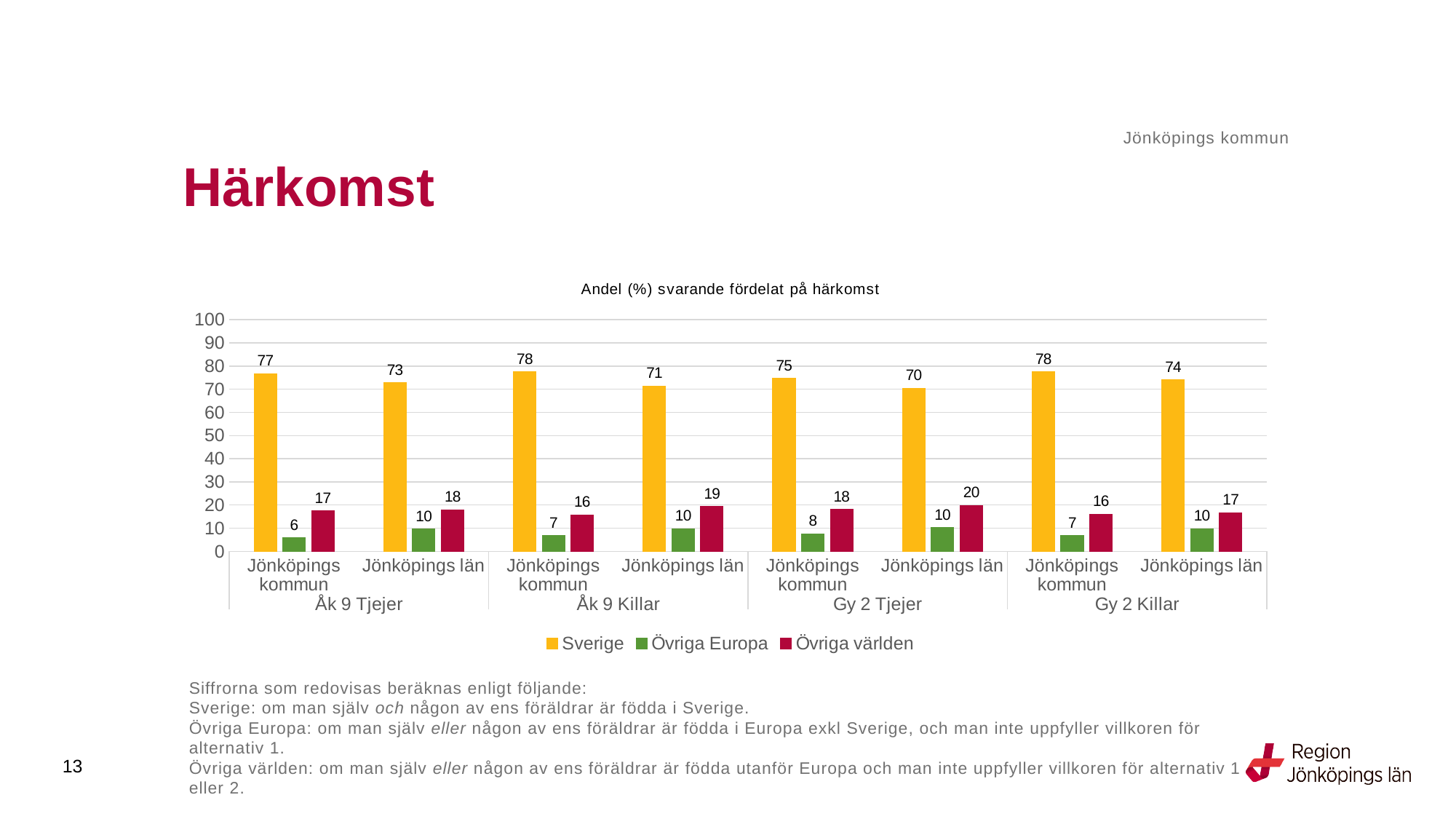
What kind of chart is shown on the slide? bar chart What is the difference between the Sverige values for Jönköpings kommun and Jönköpings län in the Gy 2 Tjejer group? 5 Which colour represents Övriga Europa in the chart? green Which is larger: Övriga världen for Jönköpings län in Åk 9 Killar or Övriga världen for Jönköpings kommun in Åk 9 Killar? Jönköpings län in Åk 9 Killar (19) Which group and area has the highest Sverige value? Jönköpings kommun in Åk 9 Killar and Gy 2 Killar (78) What is the value for Sverige for Jönköpings kommun in the Åk 9 Tjejer group? 77 Which group and area has the lowest Övriga Europa value? Jönköpings kommun in Åk 9 Tjejer (6) What is the title of the chart? Andel (%) svarande fördelat på härkomst What is the value for Övriga Europa for Jönköpings kommun in the Åk 9 Killar group? 7 Is the Sverige value for Jönköpings län in Åk 9 Killar greater or less than 80? less How many series does the legend list? 3 What is the value for Övriga världen for Jönköpings län in the Gy 2 Tjejer group? 20